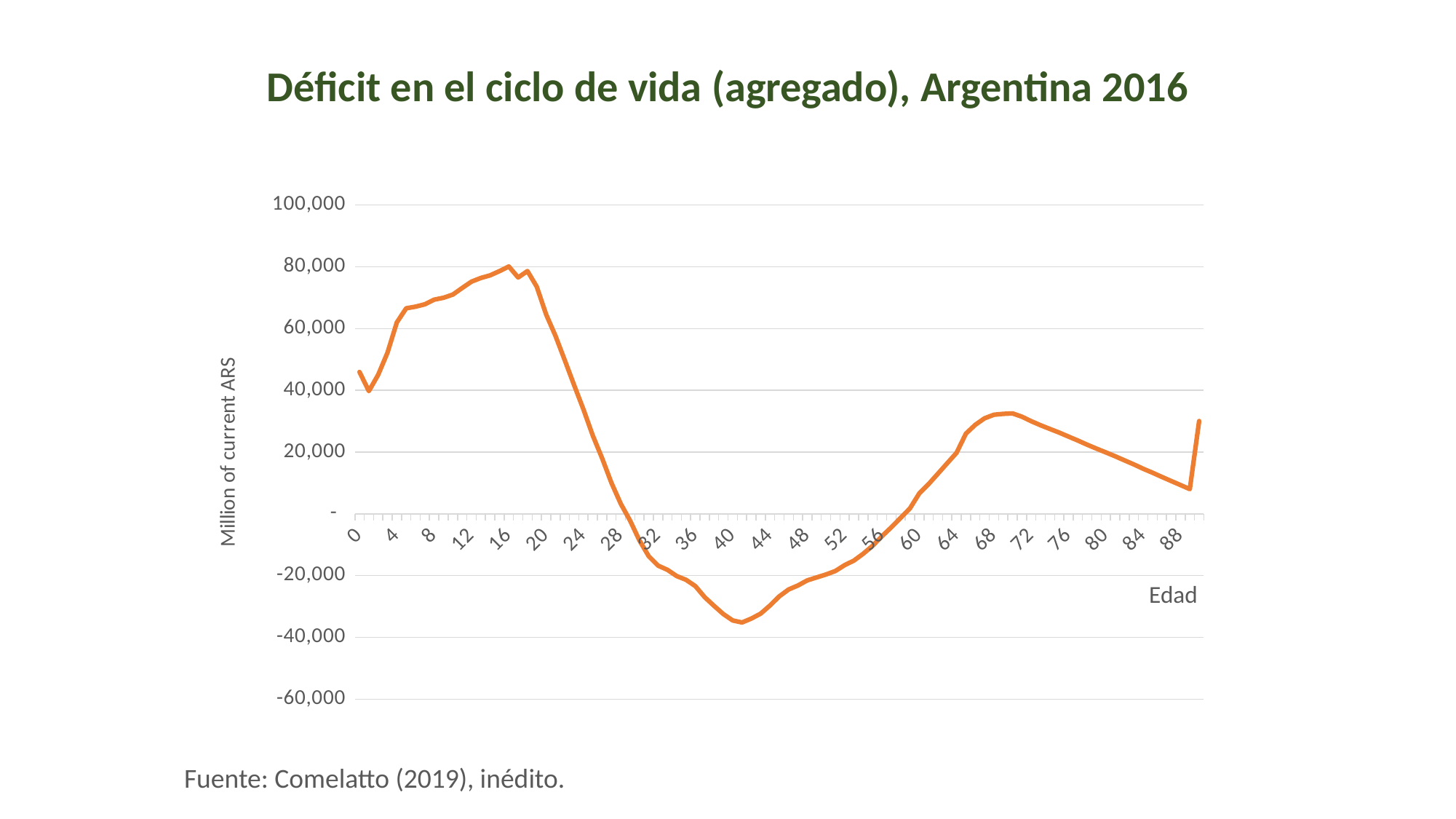
Is the value at age 32 greater or less than 0? less What is the title of the chart? Déficit en el ciclo de vida (agregado), Argentina 2016 Is the value at age 84 greater or less than 20,000? less Is the value at age 16 greater or less than 60,000? greater What is the label of the vertical axis? Million of current ARS Does the line rise or fall between age 20 and age 40? fall Is the value at age 8 larger or smaller than the value at age 80? larger Does the line rise or fall between age 44 and age 68? rise What kind of chart is shown on the slide? line chart